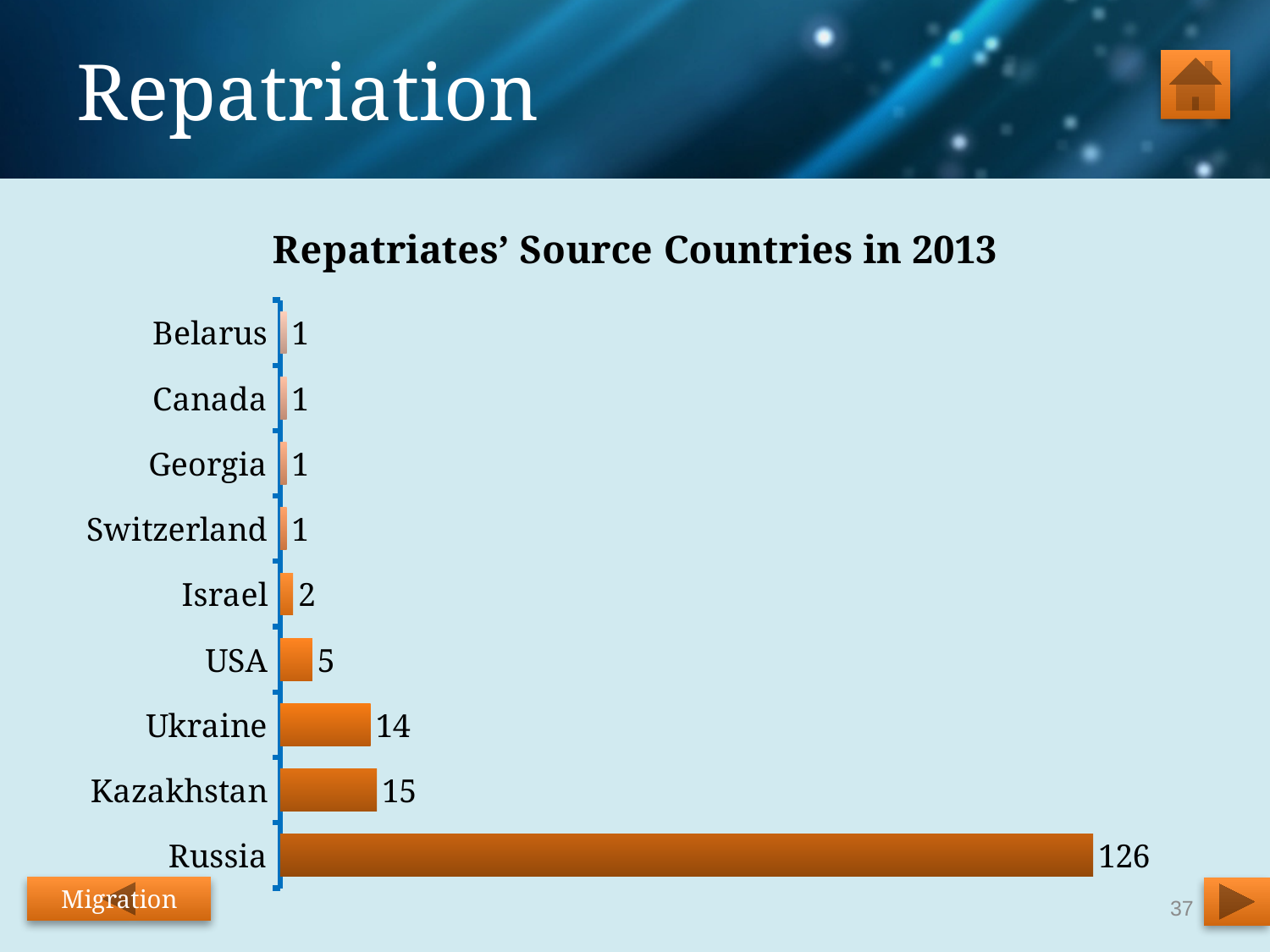
What is the value for Russia? 126 What kind of chart is shown on the slide? Bar chart What is the difference between the values for Russia and Kazakhstan? 111 Which country has the highest value? Russia What is the value for Ukraine? 14 What is the value for Kazakhstan? 15 What is the value for the USA? 5 What is the value for Israel? 2 What is the difference between the values for Ukraine and the USA? 9 Which is larger, the value for Kazakhstan or the value for Ukraine? Kazakhstan What is the title of the chart? Repatriates' Source Countries in 2013 How many countries are shown in the chart? 9